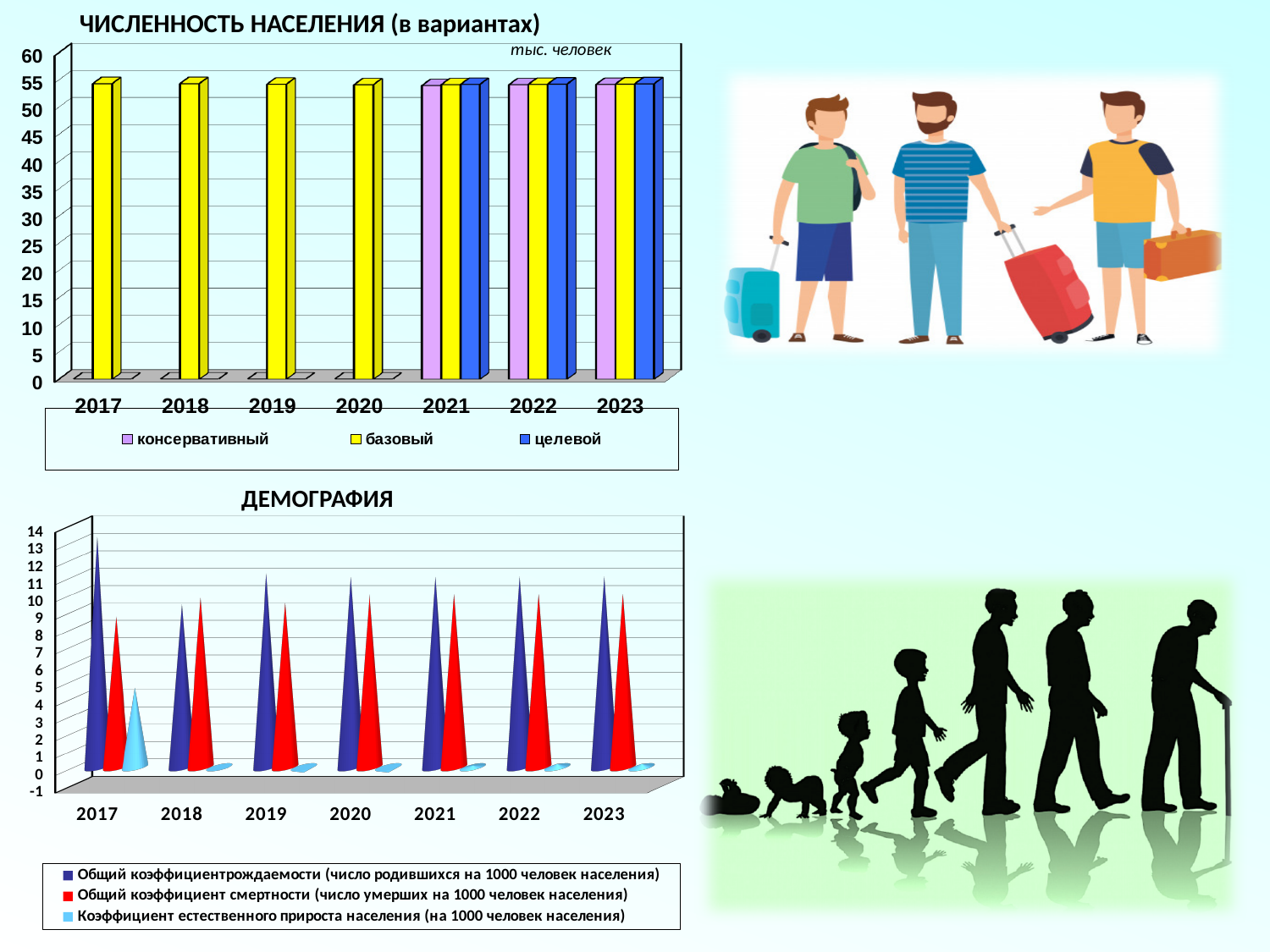
In the 'ЧИСЛЕННОСТЬ НАСЕЛЕНИЯ (в вариантах)' chart, which series is shown in yellow? базовый In the 'ЧИСЛЕННОСТЬ НАСЕЛЕНИЯ (в вариантах)' chart, is the 'базовый' value for 2017 greater or less than 50? greater How many years are shown on the x axis of the 'ДЕМОГРАФИЯ' chart? 7 In the 'ДЕМОГРАФИЯ' chart for 2017, which is larger: 'Общий коэффициент рождаемости' or 'Общий коэффициент смертности'? Общий коэффициент рождаемости In the 'ДЕМОГРАФИЯ' chart, is the 'Общий коэффициент рождаемости' value for 2017 greater or less than 10? greater What kind of chart is the 'ЧИСЛЕННОСТЬ НАСЕЛЕНИЯ (в вариантах)' chart? bar chart In the 'ДЕМОГРАФИЯ' chart, which year has the highest value for 'Общий коэффициент рождаемости'? 2017 How many series does the legend of the 'ЧИСЛЕННОСТЬ НАСЕЛЕНИЯ (в вариантах)' chart list? 3 How many years are shown on the x axis of the 'ЧИСЛЕННОСТЬ НАСЕЛЕНИЯ (в вариантах)' chart? 7 How many series does the legend of the 'ДЕМОГРАФИЯ' chart list? 3 In the 'ЧИСЛЕННОСТЬ НАСЕЛЕНИЯ (в вариантах)' chart, is the 'целевой' value for 2023 greater or less than 60? less In the 'ЧИСЛЕННОСТЬ НАСЕЛЕНИЯ (в вариантах)' chart, what unit is stated above the plot area? тыс. человек